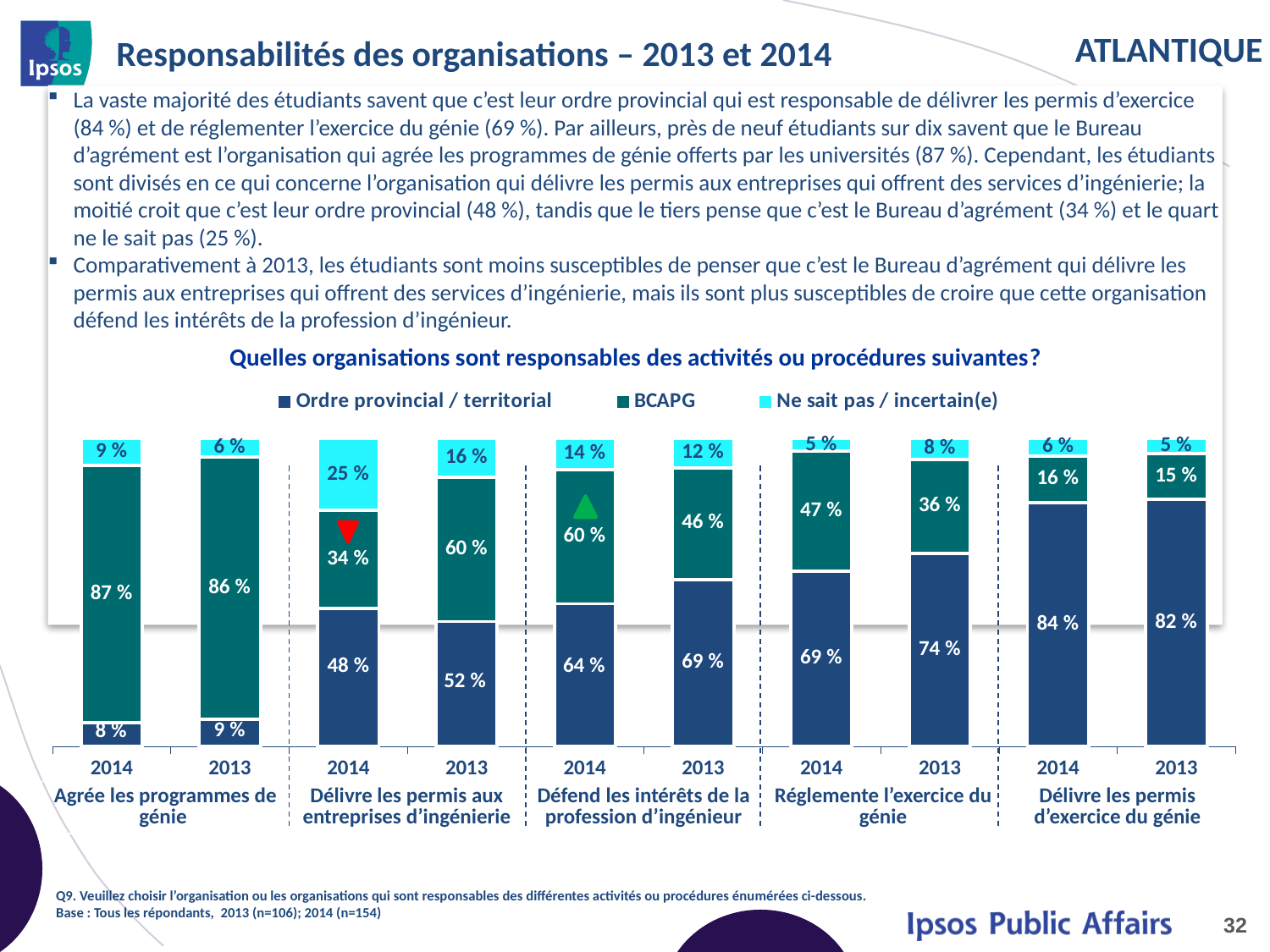
For 'Défend les intérêts de la profession d'ingénieur', is the BCAPG value larger in 2014 or in 2013? 2014 What is the 'Ne sait pas / incertain(e)' value for 'Délivre les permis aux entreprises d'ingénierie' in 2014? 25 % What is the BCAPG value for 'Agrée les programmes de génie' in 2013? 86 % What type of chart is shown on the slide? Stacked bar chart Across all bars, which bar has the lowest BCAPG value? Délivre les permis d'exercice du génie, 2013 (15 %) What is the total of the three segments in the 2014 bar for 'Réglemente l'exercice du génie'? 121 % What is the Ordre provincial / territorial value for 'Réglemente l'exercice du génie' in 2013? 74 % How many bars are plotted in the chart? 10 What is the value for Ordre provincial / territorial for 'Délivre les permis aux entreprises d'ingénierie' in 2014? 48 % How many series does the legend list? 3 What is the difference between the BCAPG values for 'Délivre les permis aux entreprises d'ingénierie' in 2013 and 2014? 26 % Across all bars, which bar has the highest Ordre provincial / territorial value? Délivre les permis d'exercice du génie, 2014 (84 %)